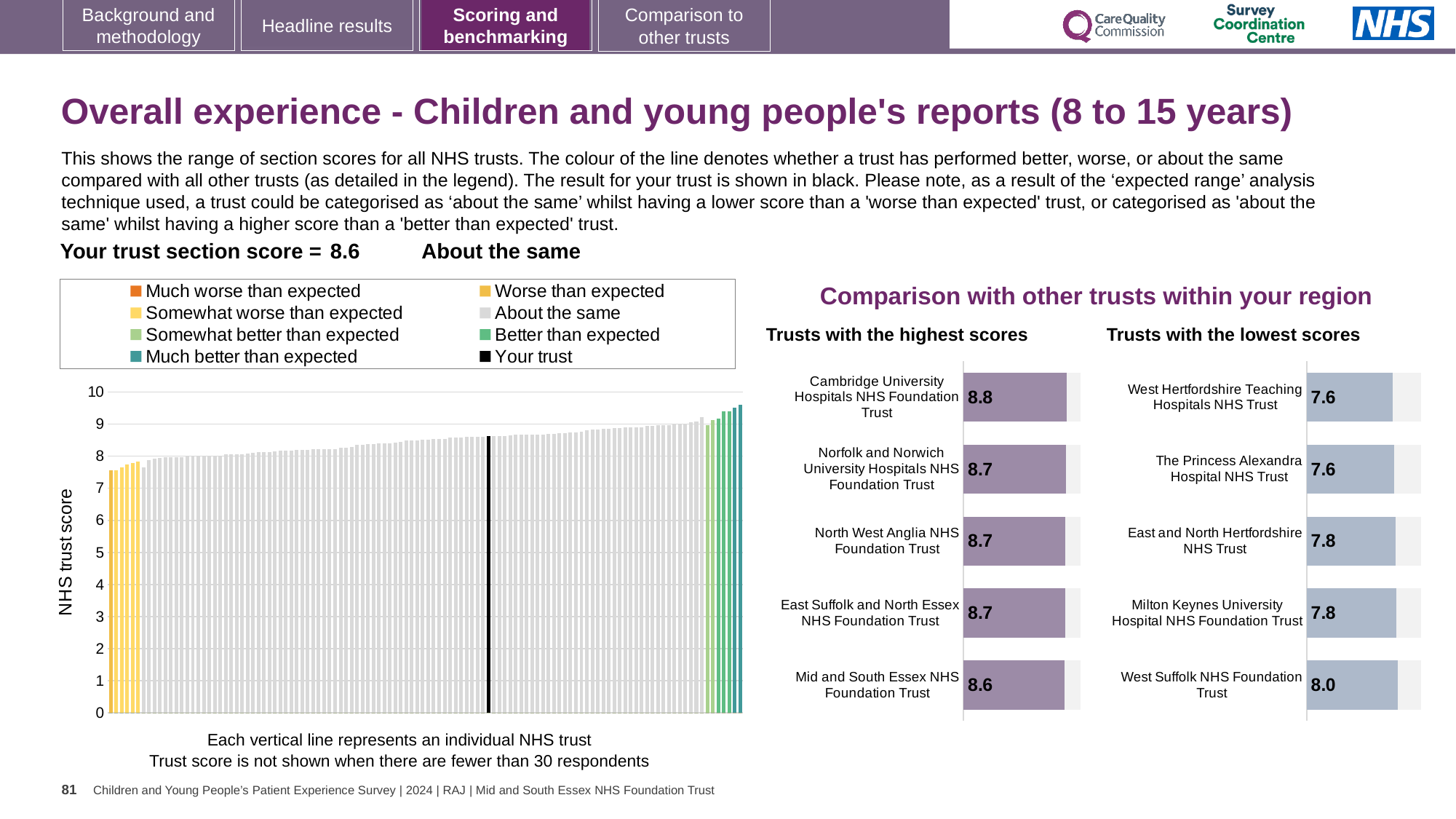
How many trusts are shown in the 'Trusts with the highest scores' chart? 5 In the 'Trusts with the lowest scores' chart, which has the larger score: West Suffolk NHS Foundation Trust or Milton Keynes University Hospital NHS Foundation Trust? West Suffolk NHS Foundation Trust In the 'Trusts with the highest scores' chart, what is the difference between the scores of Cambridge University Hospitals NHS Foundation Trust and Mid and South Essex NHS Foundation Trust? 0.2 In the 'Trusts with the highest scores' chart, what is the score for Cambridge University Hospitals NHS Foundation Trust? 8.8 What kind of chart is the main chart on the left showing NHS trust scores? Bar chart In the 'Trusts with the highest scores' chart, what is the score for Mid and South Essex NHS Foundation Trust? 8.6 In the main NHS trust score chart on the left, is the value for 'Your trust' (the black bar) greater or less than 8? greater In the 'Trusts with the highest scores' chart, which trust has the highest score? Cambridge University Hospitals NHS Foundation Trust In the 'Trusts with the lowest scores' chart, which trust has the highest score? West Suffolk NHS Foundation Trust In the 'Trusts with the lowest scores' chart, what is the score for East and North Hertfordshire NHS Trust? 7.8 In the 'Trusts with the lowest scores' chart, what is the difference between the scores of West Suffolk NHS Foundation Trust and West Hertfordshire Teaching Hospitals NHS Trust? 0.4 In the 'Trusts with the lowest scores' chart, what is the score for West Suffolk NHS Foundation Trust? 8.0